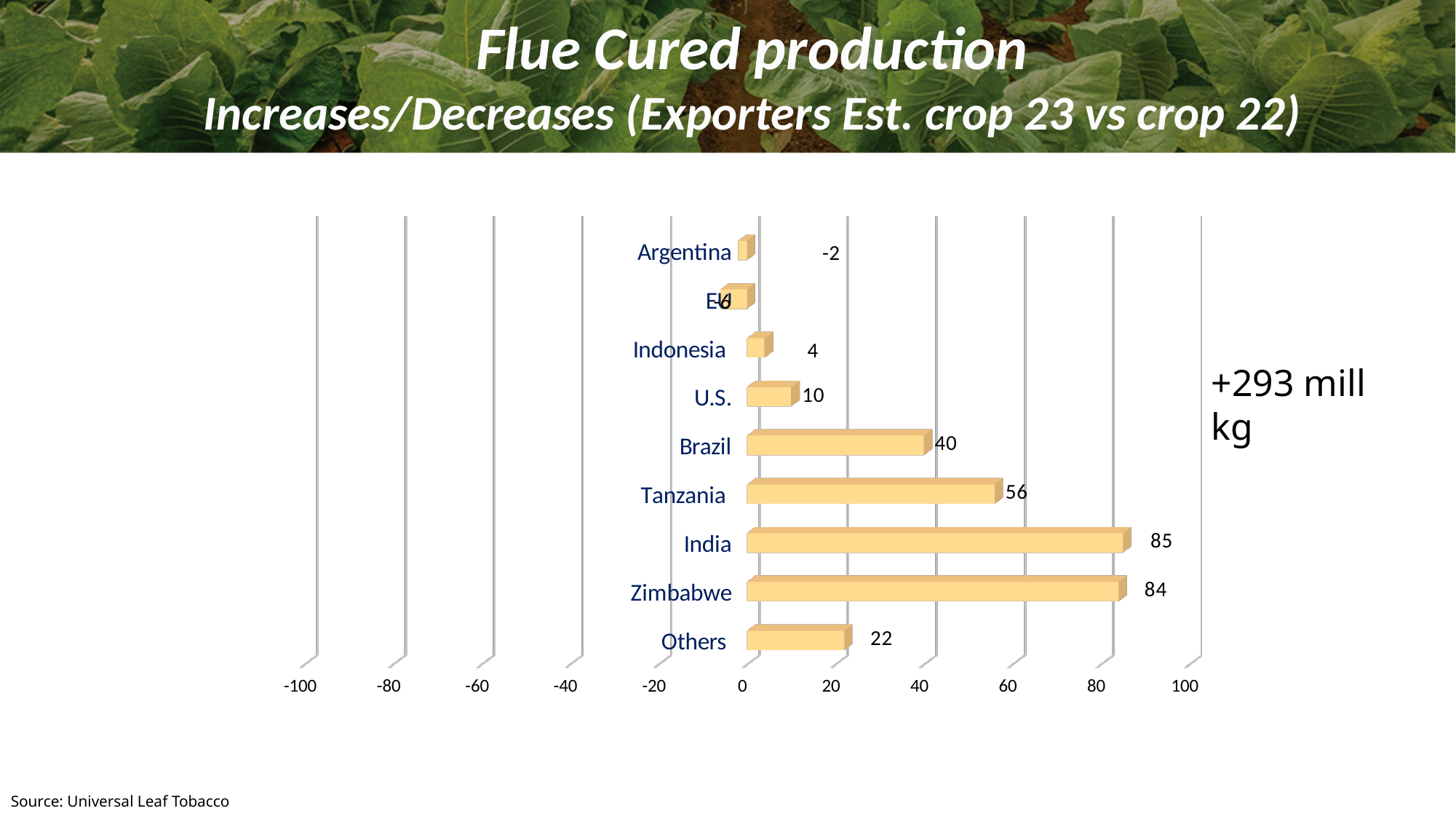
What is the difference between the values for Zimbabwe and Others? 62 What is the value shown for Argentina? -2 Which has the larger value, Brazil or Tanzania? Tanzania How many categories are plotted in the chart? 9 What is the value shown for Brazil? 40 What is the value shown for Tanzania? 56 What is the value shown for Others? 22 What is the difference between the values for India and Tanzania? 29 What is the value shown for U.S.? 10 Which country has the highest value in the chart? India What kind of chart is shown on the slide? bar chart What total figure is annotated to the right of the chart? +293 mill kg